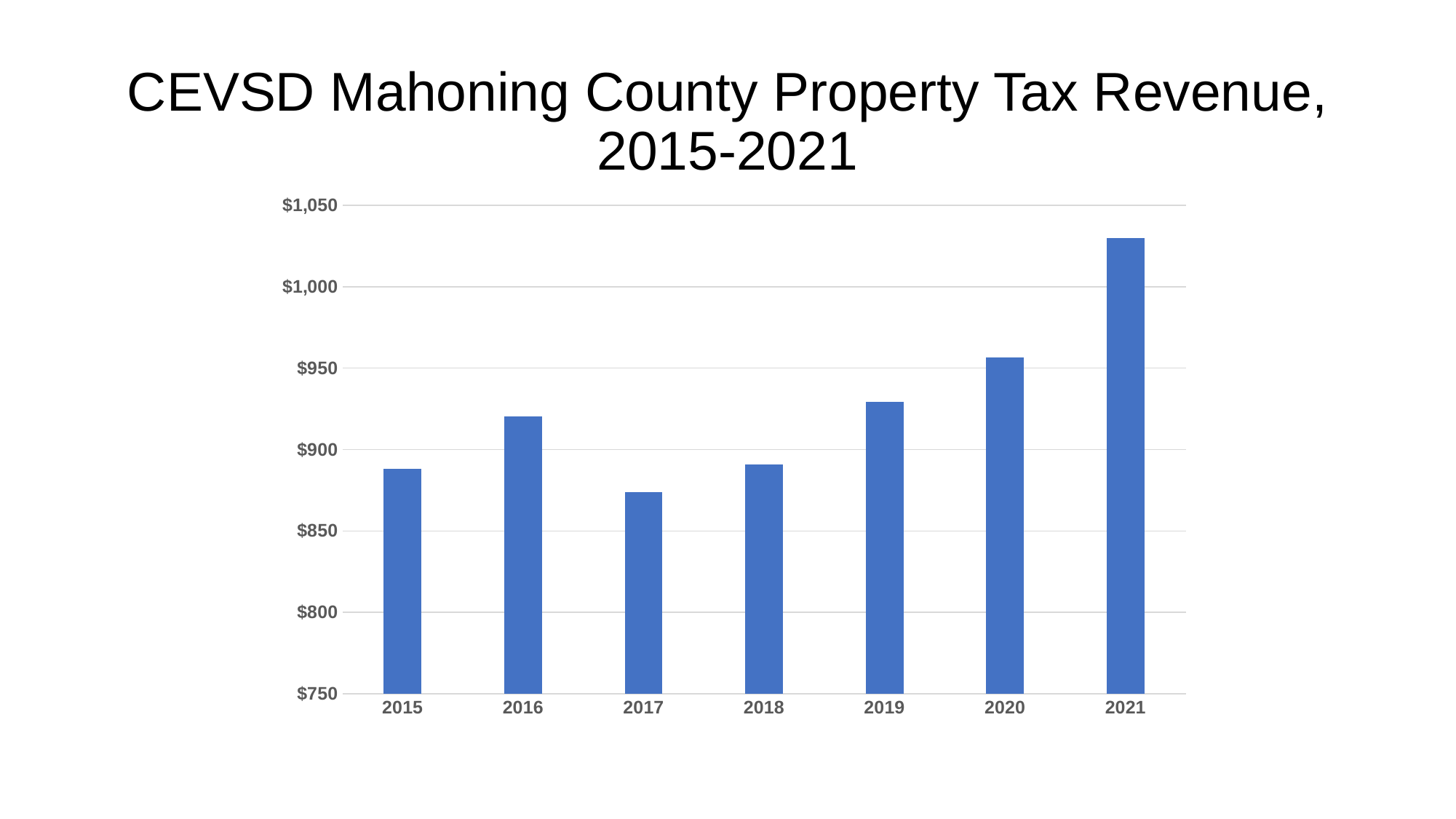
Which is larger, the value for 2020 or the value for 2019? 2020 From 2018 to 2021, do the values rise or fall? rise What type of chart is shown on the slide? Bar chart Is the value for 2016 greater or less than $900? greater Is the value for 2021 greater or less than $1,000? greater Is the value for 2019 greater or less than $950? less Which year has the lowest property tax revenue? 2017 What is the title of the chart? CEVSD Mahoning County Property Tax Revenue, 2015-2021 Which year has the highest property tax revenue? 2021 How many years are plotted on the chart? 7 Which is larger, the value for 2016 or the value for 2017? 2016